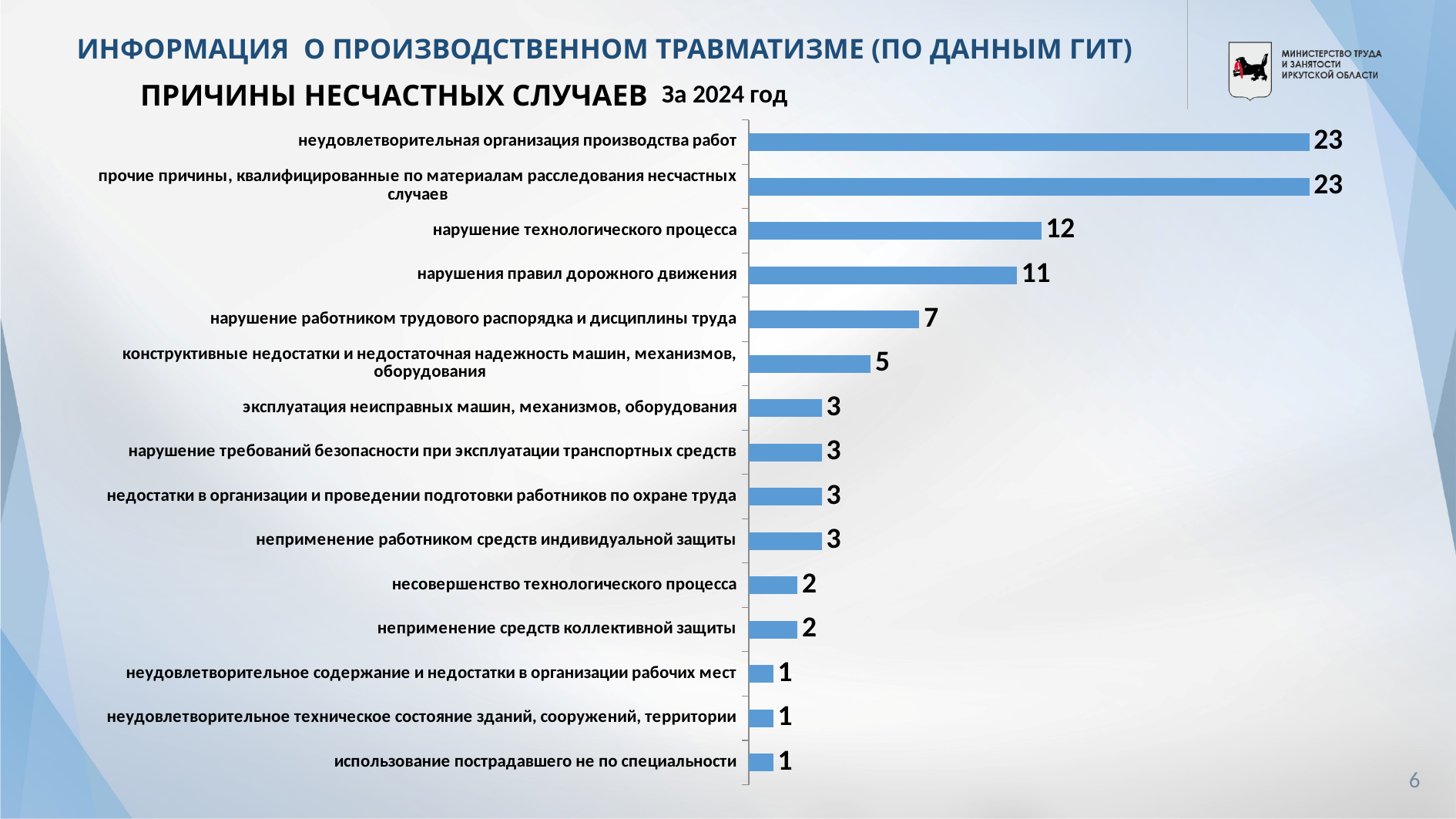
What year does the chart title say the data is for? 2024 What type of chart is shown on the slide? bar chart What is the value for 'нарушение работником трудового распорядка и дисциплины труда'? 7 What is the difference between the values for 'неудовлетворительная организация производства работ' and 'нарушение технологического процесса'? 11 How many categories (causes) are plotted in the chart? 15 What is the value for 'нарушения правил дорожного движения'? 11 What is the value for 'конструктивные недостатки и недостаточная надежность машин, механизмов, оборудования'? 5 What is the value for 'использование пострадавшего не по специальности'? 1 What is the value for 'нарушение технологического процесса'? 12 What is the highest value shown in the chart? 23 Which is larger: the value for 'нарушения правил дорожного движения' or the value for 'нарушение работником трудового распорядка и дисциплины труда'? нарушения правил дорожного движения What is the value for 'неприменение средств коллективной защиты'? 2